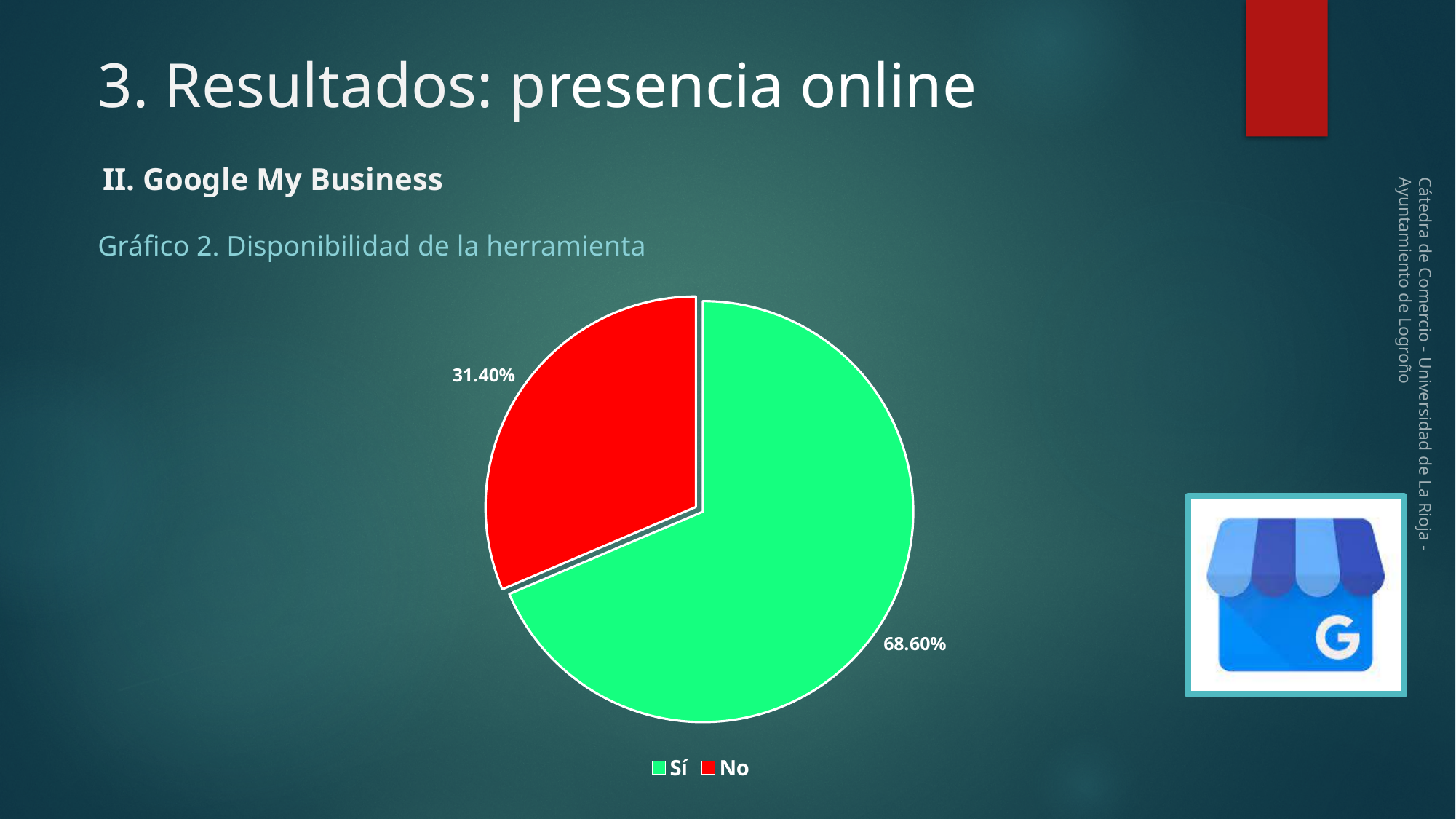
What is the title of the chart? Gráfico 2. Disponibilidad de la herramienta What share of the pie does the 'Sí' slice take? 68.60% How many entries does the legend list? 2 What percentage does the 'No' slice represent? 31.40% Which slice is the smallest in the pie chart? No How many slices does the pie chart have? 2 Which is larger, the 'Sí' slice or the 'No' slice? Sí What colour is the 'No' slice? red What percentage does the 'Sí' slice represent? 68.60% What is the difference in percentage points between the 'Sí' and 'No' slices? 37.20% What kind of chart is shown on the slide? pie chart Which slice is the largest in the pie chart? Sí